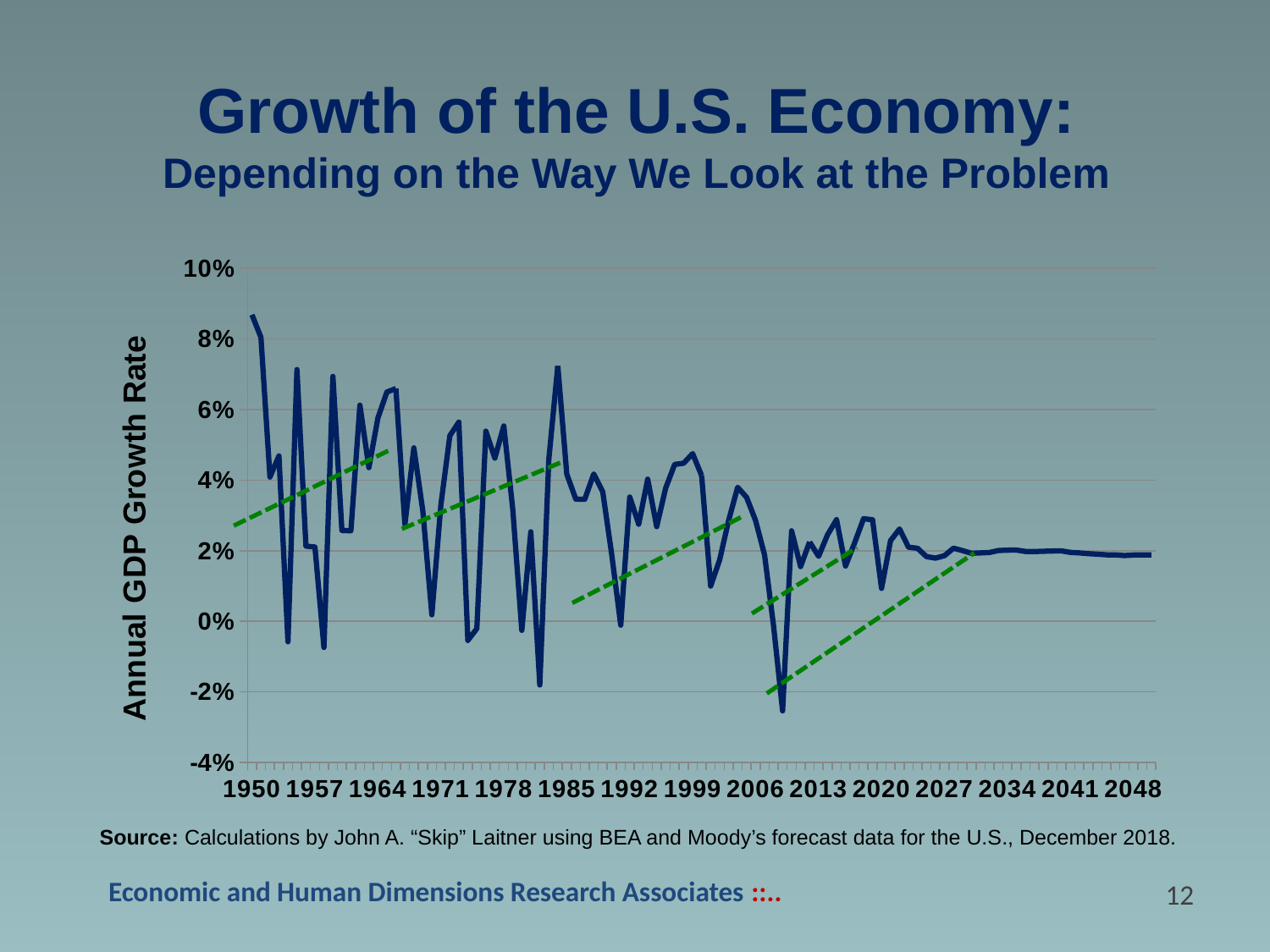
Is the value for 1950 greater or less than 8%? greater What kind of chart is shown on the slide? Line chart In which year shown on the horizontal axis does the line reach its highest value? 1950 Which year has the larger GDP growth rate, 1950 or 2048? 1950 Is the value for 2048 greater or less than 0%? greater Is the lowest point on the line greater or less than -2%? less What is the highest value shown on the vertical axis of the chart? 10% How many year labels are shown along the horizontal axis? 15 Overall, do the GDP growth rate values rise or fall from 1950 to 2048? fall What is the label on the vertical axis of the chart? Annual GDP Growth Rate What is the lowest value shown on the vertical axis of the chart? -4%